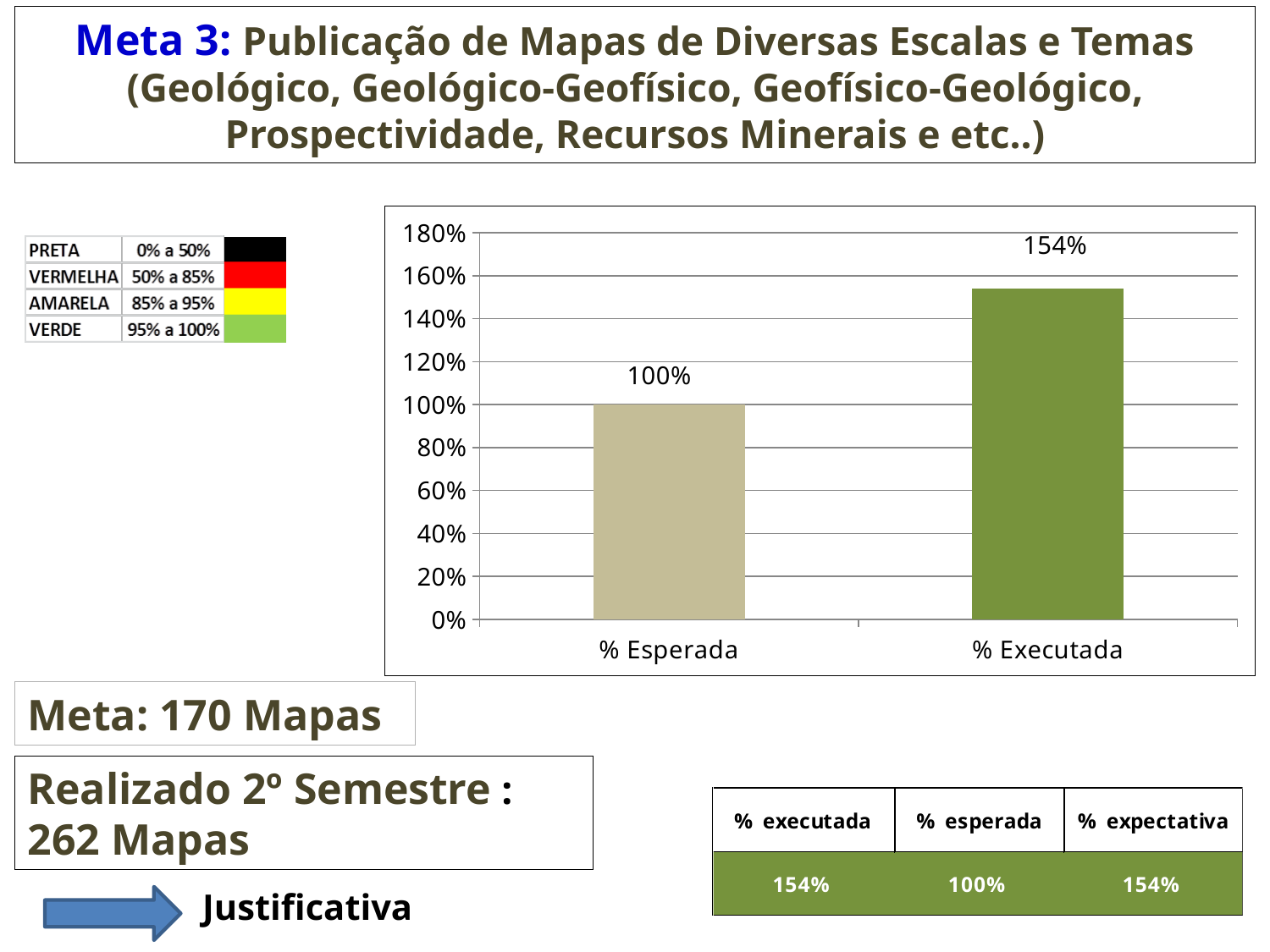
Which is larger, % Esperada or % Executada? % Executada What is the difference between % Executada and % Esperada? 54% What is the value for % Executada? 154% Which category has the highest value? % Executada What is the highest value shown on the vertical axis? 180% What colour is the bar for % Executada? green Is the value for % Executada greater or less than 140%? greater Which category has the lowest value? % Esperada What is the value for % Esperada? 100% How many categories are shown in the chart? 2 Is the value for % Esperada greater or less than 120%? less What kind of chart is shown on the slide? bar chart